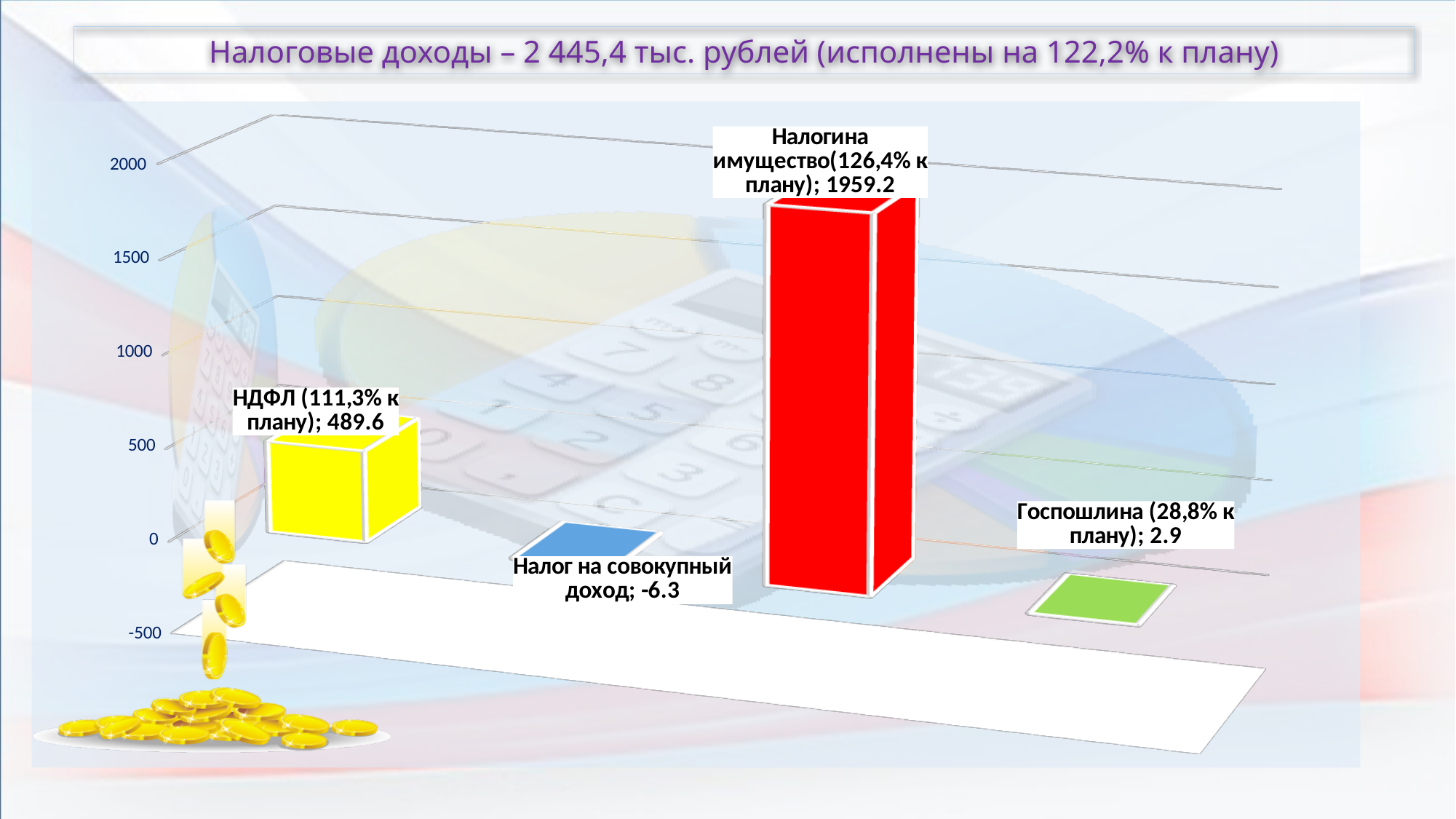
What is the value shown for Госпошлина? 2.9 Is the value for Налог на имущество greater or less than 1500? greater Which category has the lowest value? Налог на совокупный доход What is the difference between the values for Налог на имущество and НДФЛ? 1469.6 Which category has the highest value? Налог на имущество What is the value shown for НДФЛ? 489.6 What percentage of plan is shown in the data label for Госпошлина? 28,8% What is the value shown for Налог на имущество? 1959.2 Which is larger, the value for НДФЛ or the value for Госпошлина? НДФЛ What is the value shown for Налог на совокупный доход? -6.3 How many categories are plotted in the chart? 4 What kind of chart is shown on the slide? bar chart